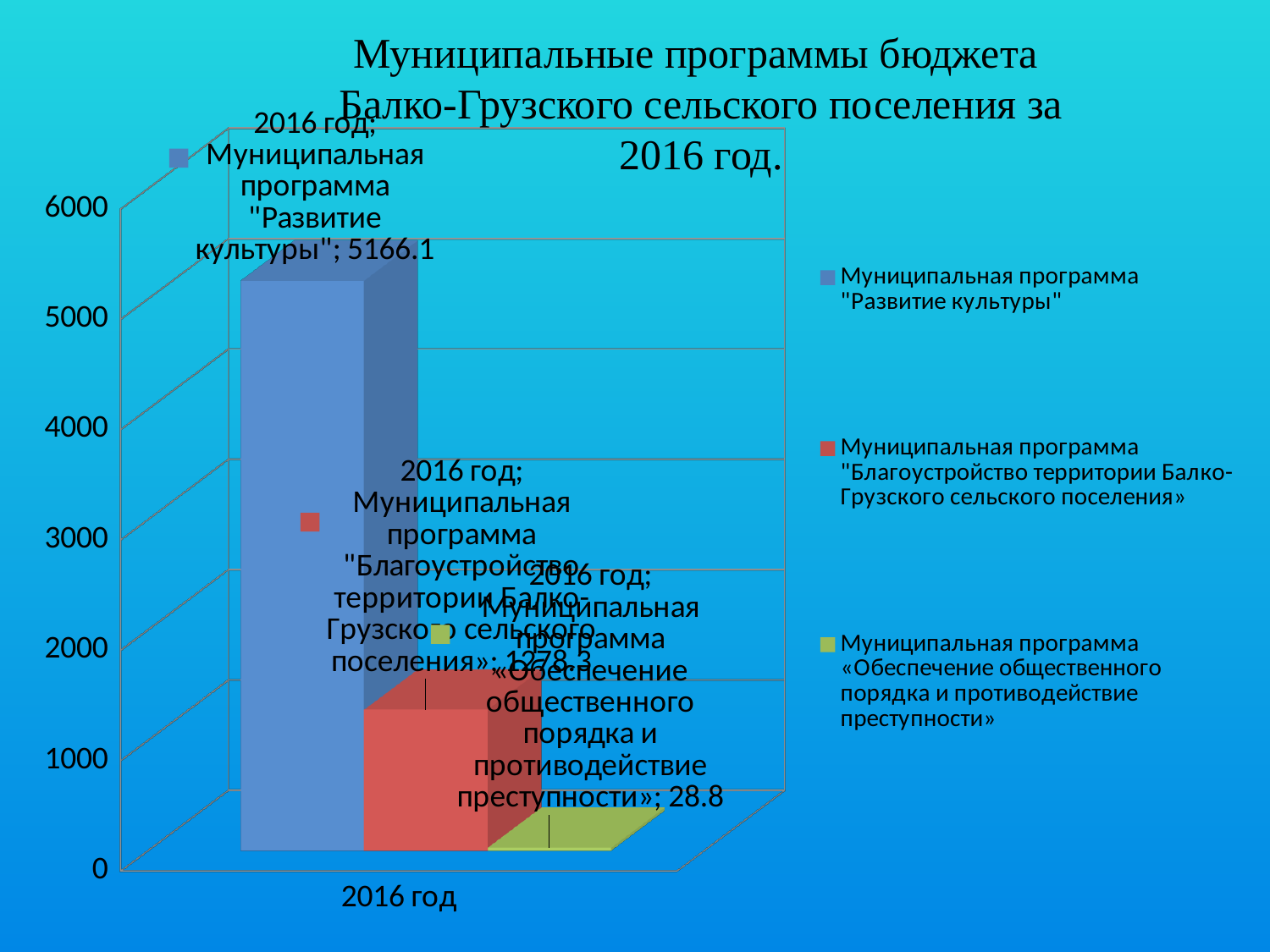
What category label is shown on the x axis? 2016 год What is the value for the series Муниципальная программа «Обеспечение общественного порядка и противодействие преступности»? 28.8 What kind of chart is shown on the slide? bar chart Which series has the highest value? Муниципальная программа "Развитие культуры" What is the value for the series Муниципальная программа "Развитие культуры"? 5166.1 What is the difference between the value for "Развитие культуры" and the value for «Обеспечение общественного порядка и противодействие преступности»? 5137.3 Which is larger: the value for "Развитие культуры" or the value for "Благоустройство территории Балко-Грузского сельского поселения"? Развитие культуры Is the value for "Развитие культуры" greater or less than 5000? greater How many series does the legend list? 3 What is the value for the series Муниципальная программа "Благоустройство территории Балко-Грузского сельского поселения"? 1278.3 Which series has the lowest value? Муниципальная программа «Обеспечение общественного порядка и противодействие преступности» Is the value for "Благоустройство территории Балко-Грузского сельского поселения" greater or less than 2000? less